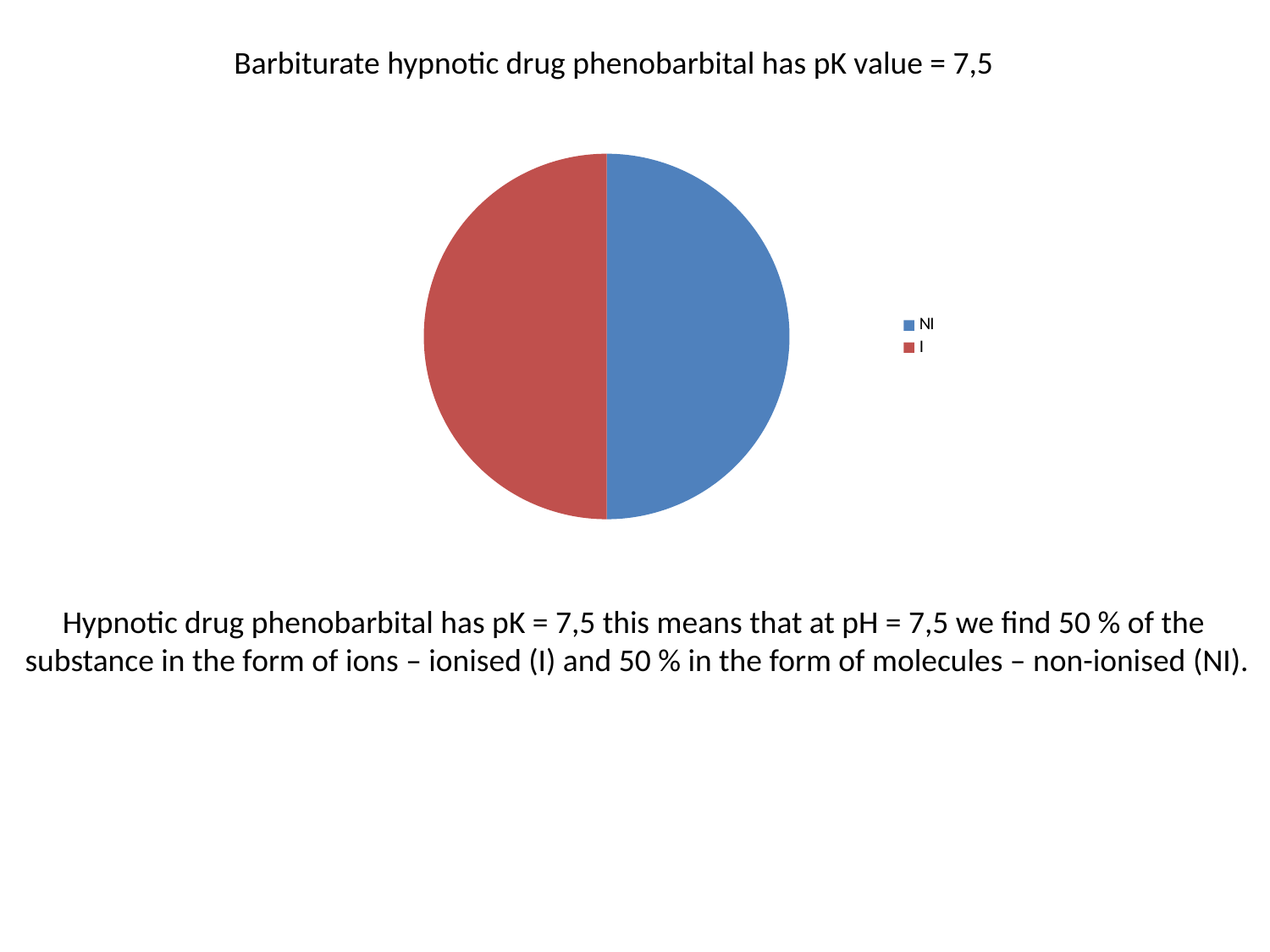
What share of the pie does the I slice represent? 50 % What share of the pie does the NI slice represent? 50 % How many slices does the pie chart have? 2 How many entries does the legend of the pie chart list? 2 Which colour is used for the NI slice in the pie chart? blue Which legend entry is shown in red? I What kind of chart is shown on the slide? pie chart